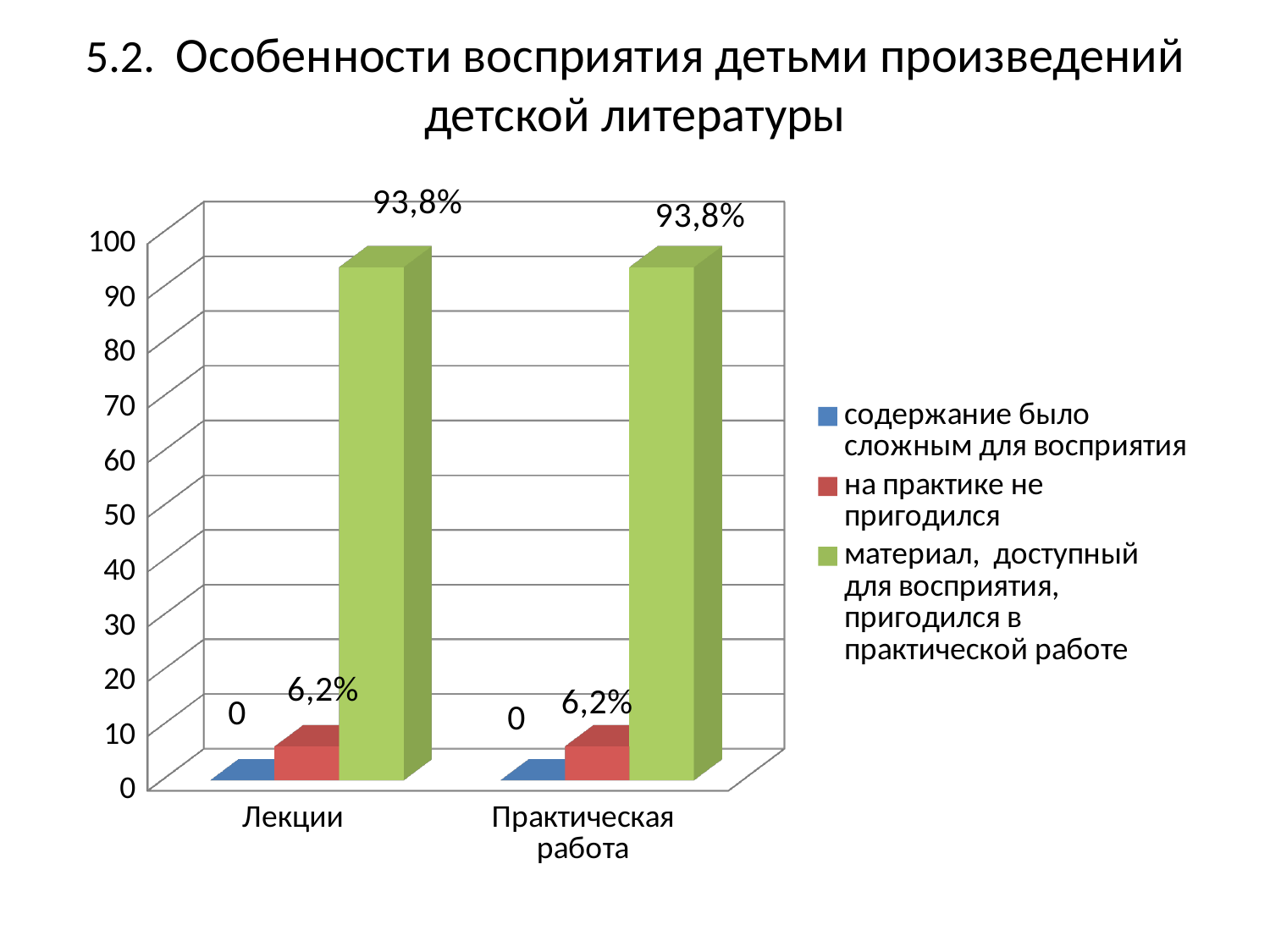
How many categories are shown on the x axis of the chart? 2 What is the value for "на практике не пригодился" in the "Практическая работа" category? 6,2% Which series has the highest value in the "Практическая работа" category? материал, доступный для восприятия, пригодился в практической работе What is the value for "материал, доступный для восприятия, пригодился в практической работе" in the "Лекции" category? 93,8% What kind of chart is shown on the slide? bar chart How many series does the legend list? 3 What is the difference between the "материал, доступный для восприятия, пригодился в практической работе" value and the "на практике не пригодился" value in the "Лекции" category? 87,6% What colour are the bars for the series "на практике не пригодился"? red Which series has the lowest value in the "Лекции" category? содержание было сложным для восприятия Is the value for "материал, доступный для восприятия, пригодился в практической работе" in the "Лекции" category greater or less than 90? greater What is the value for "содержание было сложным для восприятия" in the "Лекции" category? 0 Which is larger in the "Практическая работа" category: "на практике не пригодился" or "содержание было сложным для восприятия"? на практике не пригодился